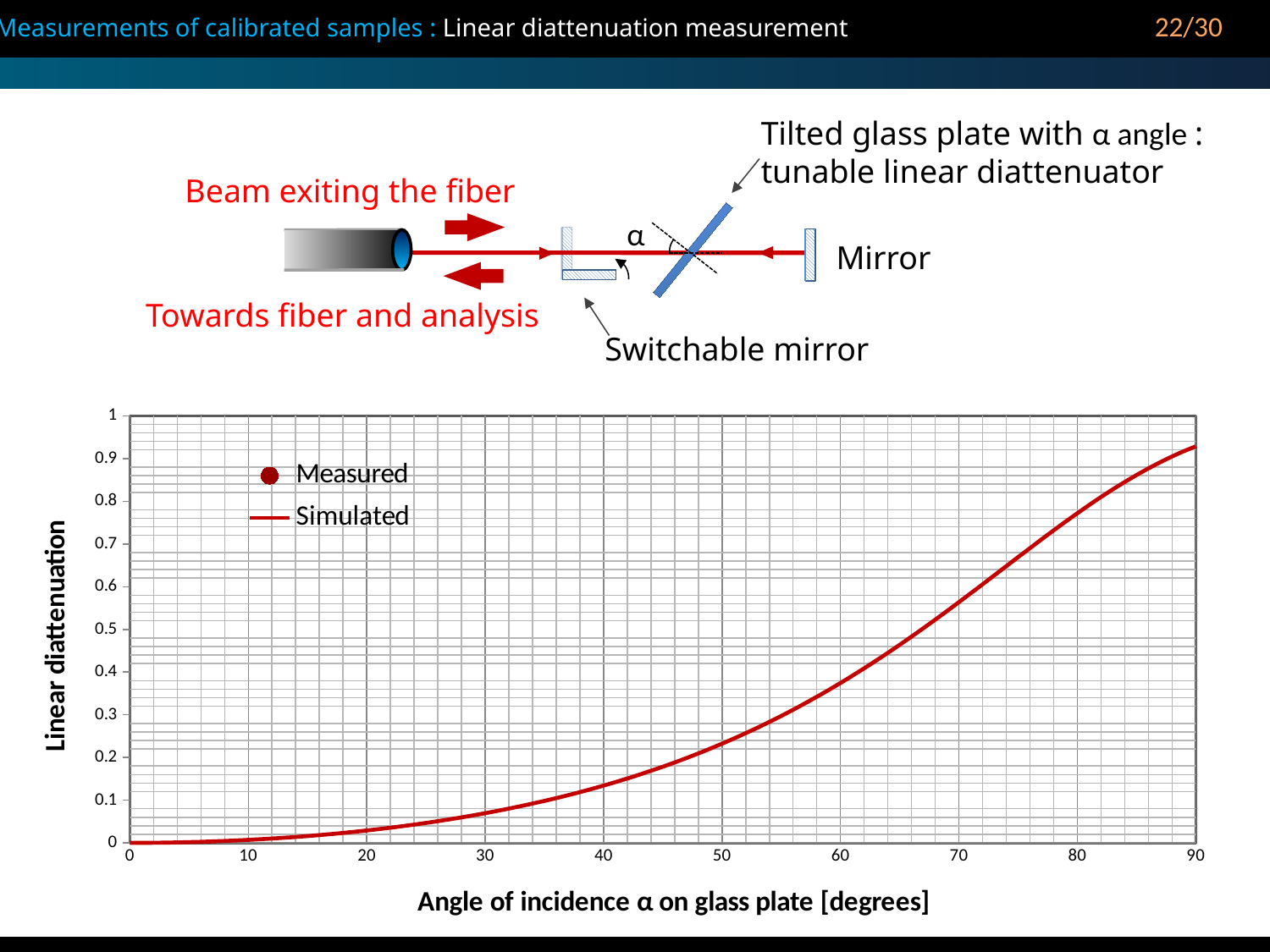
Is the simulated linear diattenuation at an angle of incidence of 50 degrees greater or less than 0.3? less Is the simulated linear diattenuation at an angle of incidence of 60 degrees greater or less than 0.3? greater What are the two entries in the chart legend? Measured and Simulated What kind of chart is shown on the slide? line chart What is the title of the x axis of the chart? Angle of incidence α on glass plate [degrees] Is the simulated linear diattenuation at an angle of incidence of 90 degrees greater or less than 0.9? greater How many series does the chart legend list? 2 Does the simulated linear diattenuation rise or fall as the angle of incidence increases from 0 to 90 degrees? rise Is the simulated linear diattenuation larger at 70 degrees or at 40 degrees? 70 degrees Which angle of incidence shown on the x axis gives the highest simulated linear diattenuation? 90